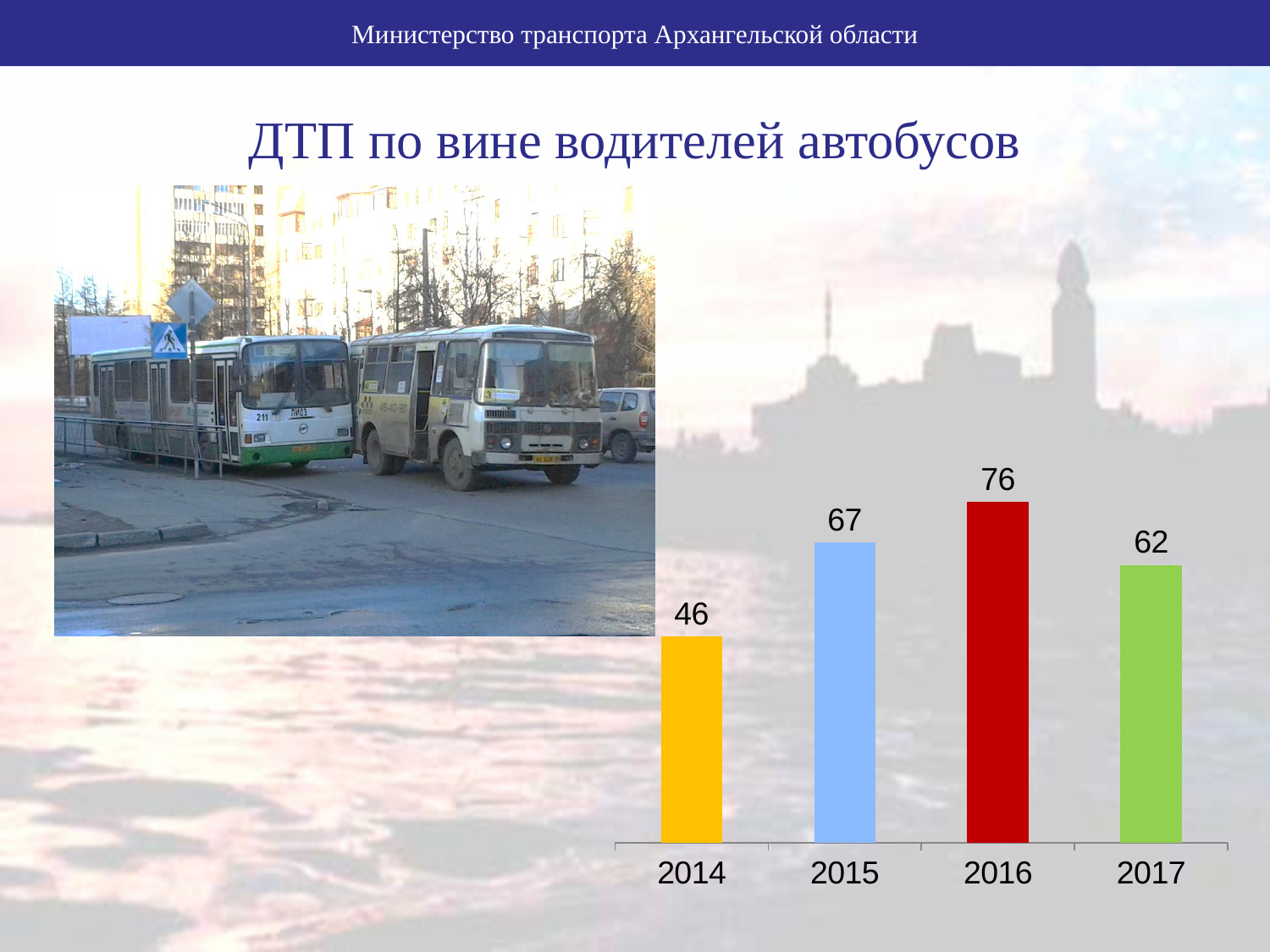
Which year has the highest value? 2016 How many years are shown on the chart? 4 Which year has the lowest value? 2014 What is the value for 2014? 46 Do the values rise or fall from 2014 to 2016? rise What is the title of the slide containing the chart? ДТП по вине водителей автобусов What is the value for 2017? 62 What is the difference between the values for 2016 and 2014? 30 What kind of chart is shown on the slide? bar chart What is the difference between the values for 2015 and 2017? 5 Which is larger, the value for 2015 or the value for 2017? 2015 What is the value for 2016? 76